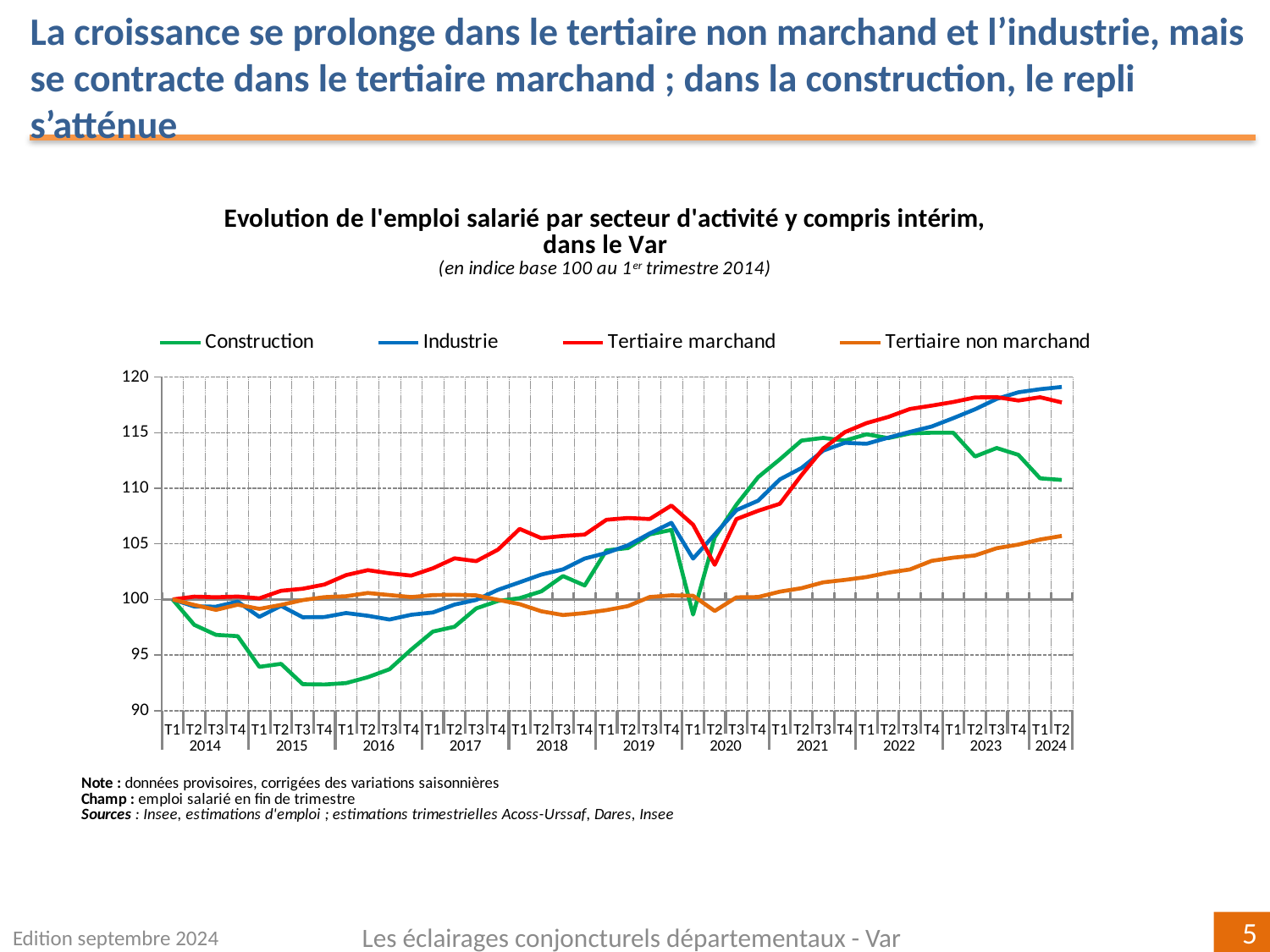
What colour is the Construction line? Green At T2 2024, which is larger: Industrie or Construction? Industrie Does the Construction series rise or fall between T1 2023 and T2 2024? fall Is the value for Tertiaire marchand at T1 2020 greater or less than 105? greater Which series is the lowest at T2 2024? Tertiaire non marchand How many years are labelled on the x axis? 11 Which series is the lowest at T4 2015? Construction How many series does the legend list? 4 What kind of chart is shown on the slide? Line chart Which series is the highest at T2 2024? Industrie Is the value for Industrie at T2 2024 greater or less than 115? greater Is the value for Construction at T4 2015 greater or less than 95? less